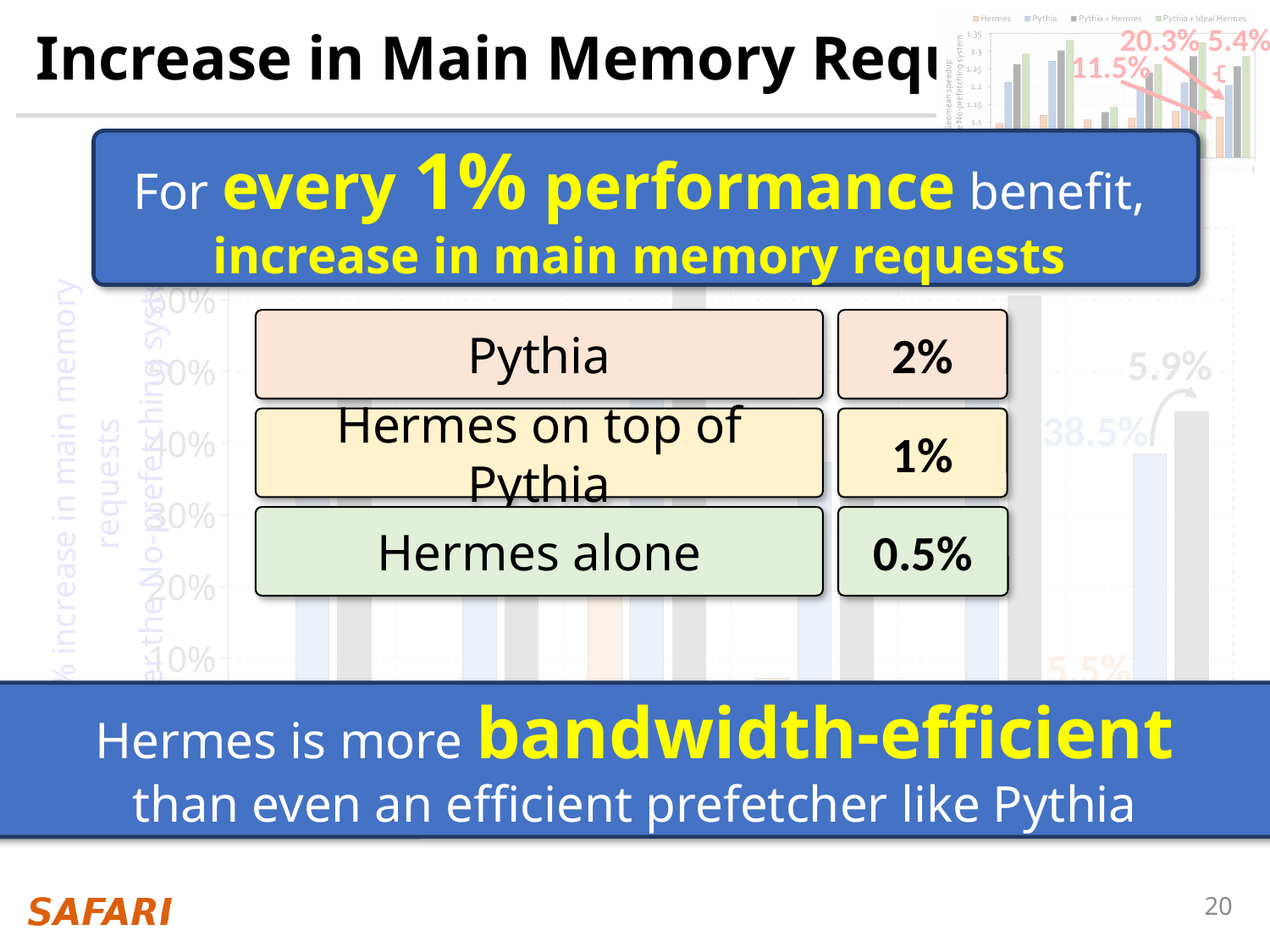
According to the summary boxes over the chart, what is the increase in main memory requests for every 1% performance benefit for Hermes on top of Pythia? 1% What kind of chart is the small inset chart in the top-right corner of the slide? bar chart What are the legend entries of the small inset chart in the top-right corner? Hermes, Pythia, Pythia + Hermes, Pythia + Ideal Hermes According to the summary boxes over the chart, which configuration has the smallest increase in main memory requests per 1% performance benefit? Hermes alone According to the summary boxes over the chart, what is the increase in main memory requests for every 1% performance benefit for Hermes alone? 0.5% What kind of chart is the large faded chart in the background of the slide? bar chart What is the highest y-axis tick label shown on the large background chart? 60% According to the summary boxes over the chart, what is the difference between the increase in main memory requests per 1% performance benefit for Pythia and for Hermes alone? 1.5% How many series does the legend of the small inset chart in the top-right corner list? 4 Which percentage values are annotated on the small inset chart in the top-right corner? 11.5%, 20.3%, 5.4% What is the largest percentage value annotated on the large background chart? 38.5% According to the summary boxes over the chart, what is the increase in main memory requests for every 1% performance benefit for Pythia? 2%